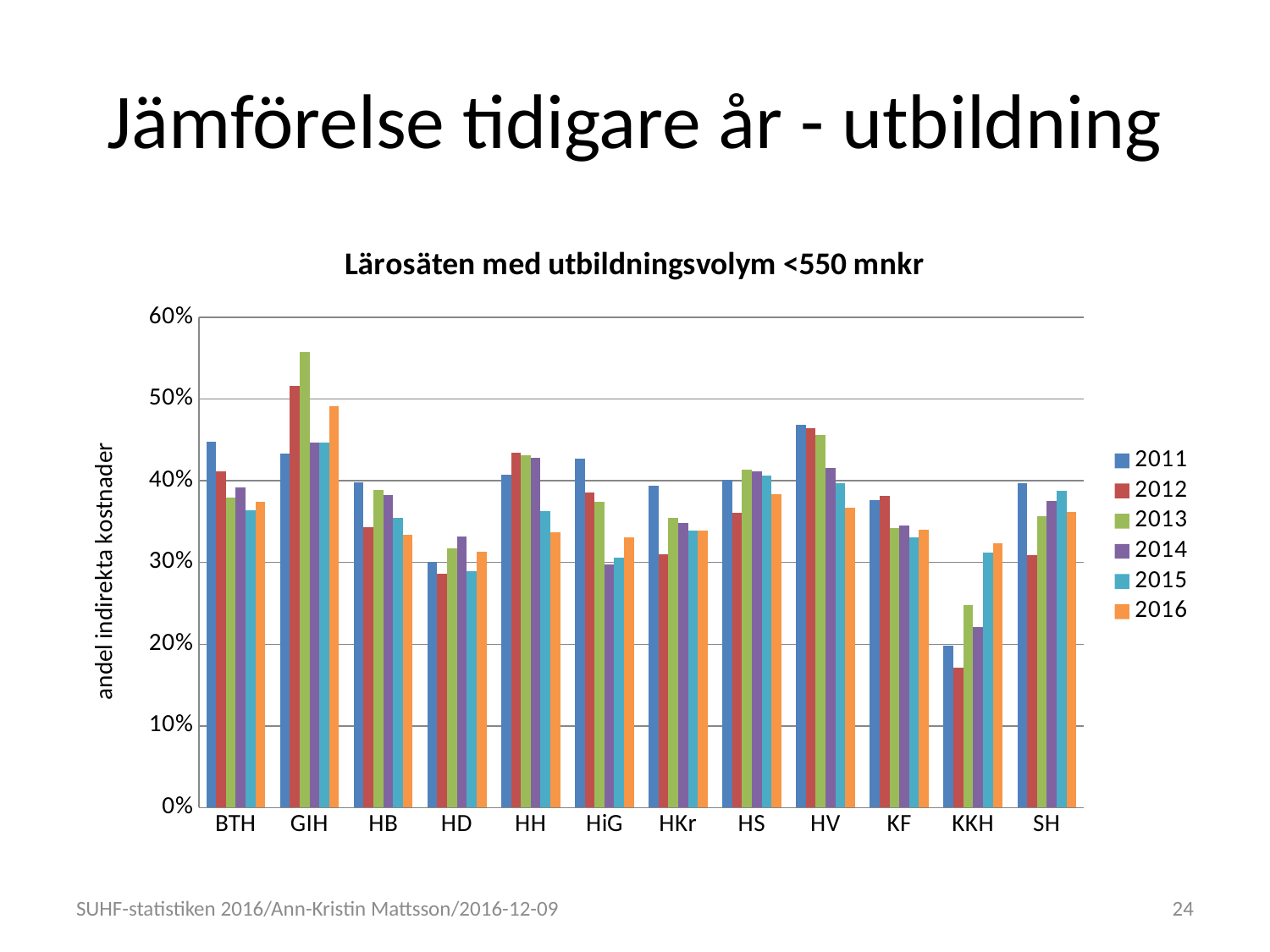
Is the 2011 value for HV greater or less than 40%? greater How many series does the legend list? 6 Is the 2013 value for GIH greater or less than 50%? greater What is the title of the chart? Lärosäten med utbildningsvolym <550 mnkr Is the 2012 value for KKH greater or less than 20%? less What kind of chart is shown on the slide? bar chart Which category has the lowest bar in the chart? KKH How many categories (lärosäten) are shown on the x axis? 12 Which is larger for SH: the 2011 value or the 2012 value? 2011 Which is larger for 2011: the value for HD or the value for HH? HH Which category has the highest bar in the chart? GIH